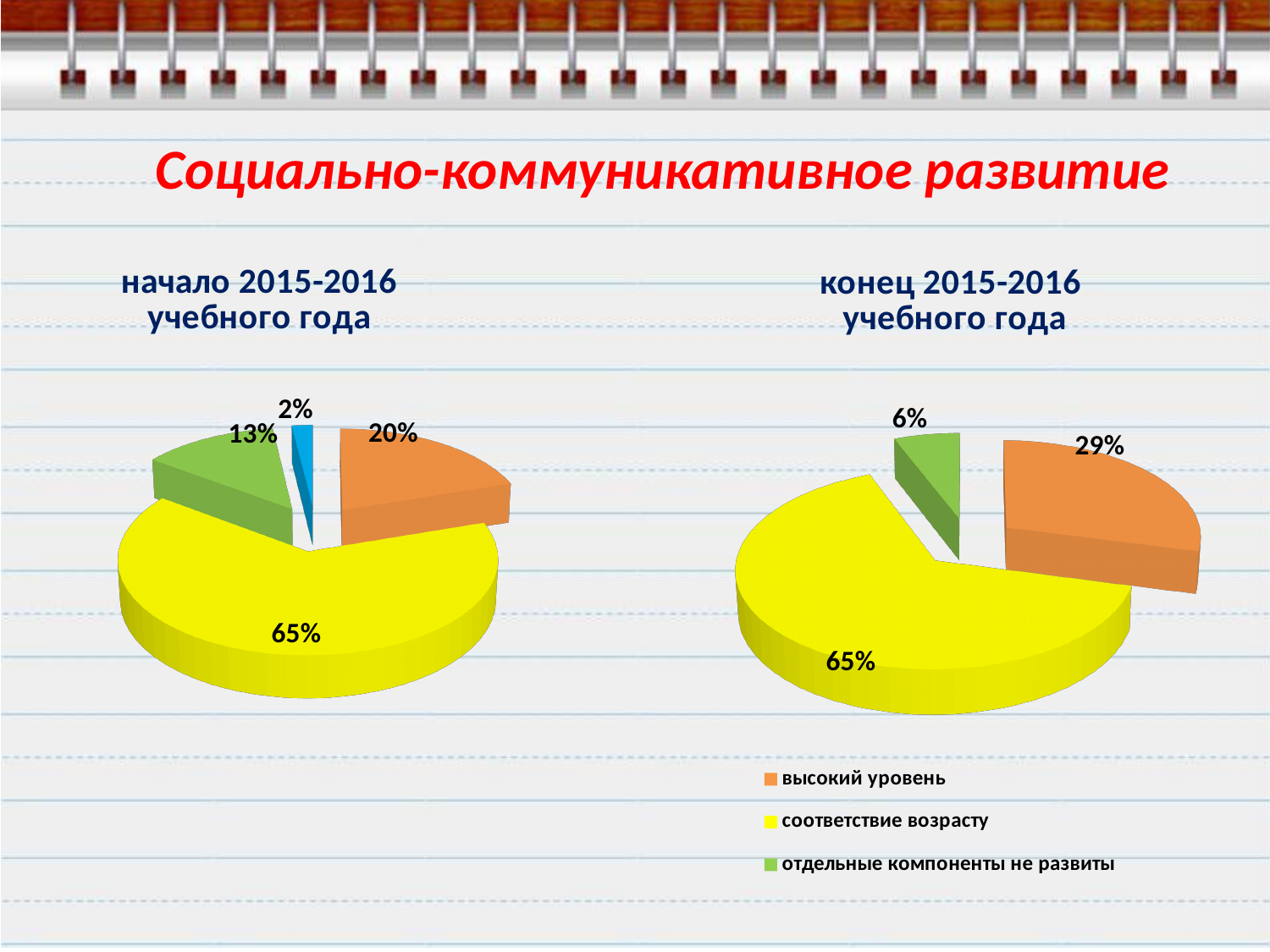
In the chart titled "начало 2015-2016 учебного года", what share does "высокий уровень" have? 20% In the chart titled "начало 2015-2016 учебного года", which category has the largest slice? соответствие возрасту How many entries does the legend list? 3 In the chart titled "конец 2015-2016 учебного года", what share does "соответствие возрасту" have? 65% In the chart titled "начало 2015-2016 учебного года", what share does "отдельные компоненты не развиты" have? 13% In the chart titled "начало 2015-2016 учебного года", what is the value of the smallest slice? 2% In the chart titled "конец 2015-2016 учебного года", which category has the smallest slice? отдельные компоненты не развиты What kind of chart is used on the slide? pie chart In the chart titled "конец 2015-2016 учебного года", what share does "высокий уровень" have? 29% In the chart titled "конец 2015-2016 учебного года", what share does "отдельные компоненты не развиты" have? 6% Which chart has the larger share for "отдельные компоненты не развиты": "начало 2015-2016 учебного года" or "конец 2015-2016 учебного года"? начало 2015-2016 учебного года By how many percentage points did the share of "высокий уровень" change from the "начало 2015-2016 учебного года" chart to the "конец 2015-2016 учебного года" chart? 9%